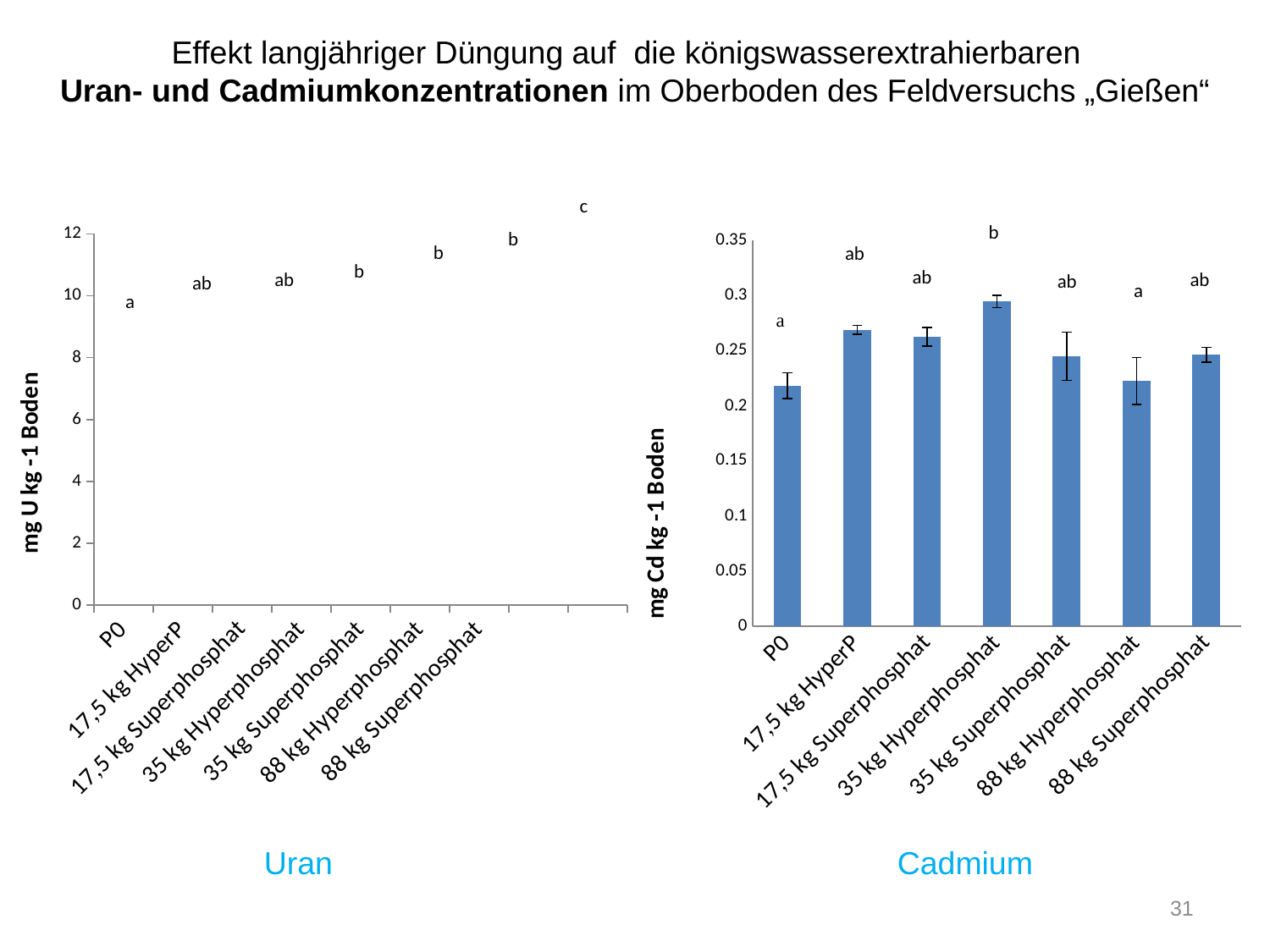
How many categories are shown on the x axis of the Cadmium chart? 7 In the Cadmium chart, is the value for P0 greater or less than 0.25? less What kind of chart is the Cadmium chart? bar chart What is the y-axis label of the Uran chart? mg U kg -1 Boden In the Cadmium chart, which category has the highest value? 35 kg Hyperphosphat In the Cadmium chart, which is larger: the value for 17,5 kg HyperP or the value for 88 kg Hyperphosphat? 17,5 kg HyperP What is the highest tick value on the y axis of the Uran chart? 12 In the Cadmium chart, is the value for 35 kg Hyperphosphat greater or less than 0.25? greater In the Cadmium chart, is the value for 88 kg Hyperphosphat greater or less than 0.25? less How many categories are shown on the x axis of the Uran chart? 7 What is the y-axis label of the Cadmium chart? mg Cd kg -1 Boden In the Cadmium chart, which is larger: the value for 35 kg Hyperphosphat or the value for P0? 35 kg Hyperphosphat